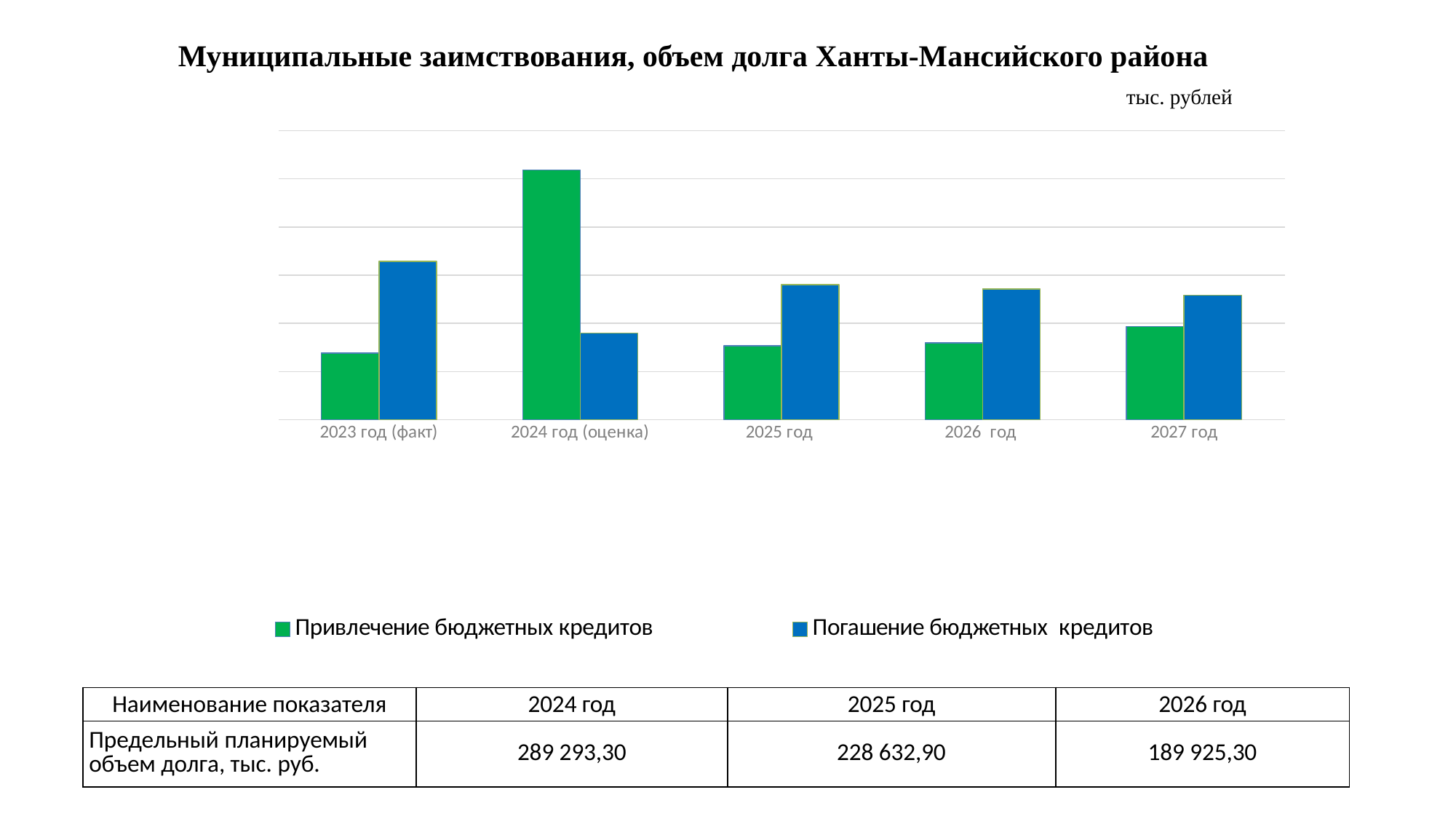
In which year is the value for Привлечение бюджетных кредитов the highest? 2024 год (оценка) Does the value for Привлечение бюджетных кредитов rise or fall from 2024 год (оценка) to 2025 год? fall In 2024 год (оценка), which is larger: Привлечение бюджетных кредитов or Погашение бюджетных кредитов? Привлечение бюджетных кредитов In which year is the value for Погашение бюджетных кредитов the lowest? 2024 год (оценка) What is the title of the chart? Муниципальные заимствования, объем долга Ханты-Мансийского района In which year is the value for Погашение бюджетных кредитов the highest? 2023 год (факт) How many year categories are shown on the x axis of the chart? 5 Which colour represents Погашение бюджетных кредитов in the chart? blue In 2027 год, which is larger: Привлечение бюджетных кредитов or Погашение бюджетных кредитов? Погашение бюджетных кредитов In 2023 год (факт), which is larger: Привлечение бюджетных кредитов or Погашение бюджетных кредитов? Погашение бюджетных кредитов What kind of chart is shown on the slide? bar chart How many series does the chart legend list? 2